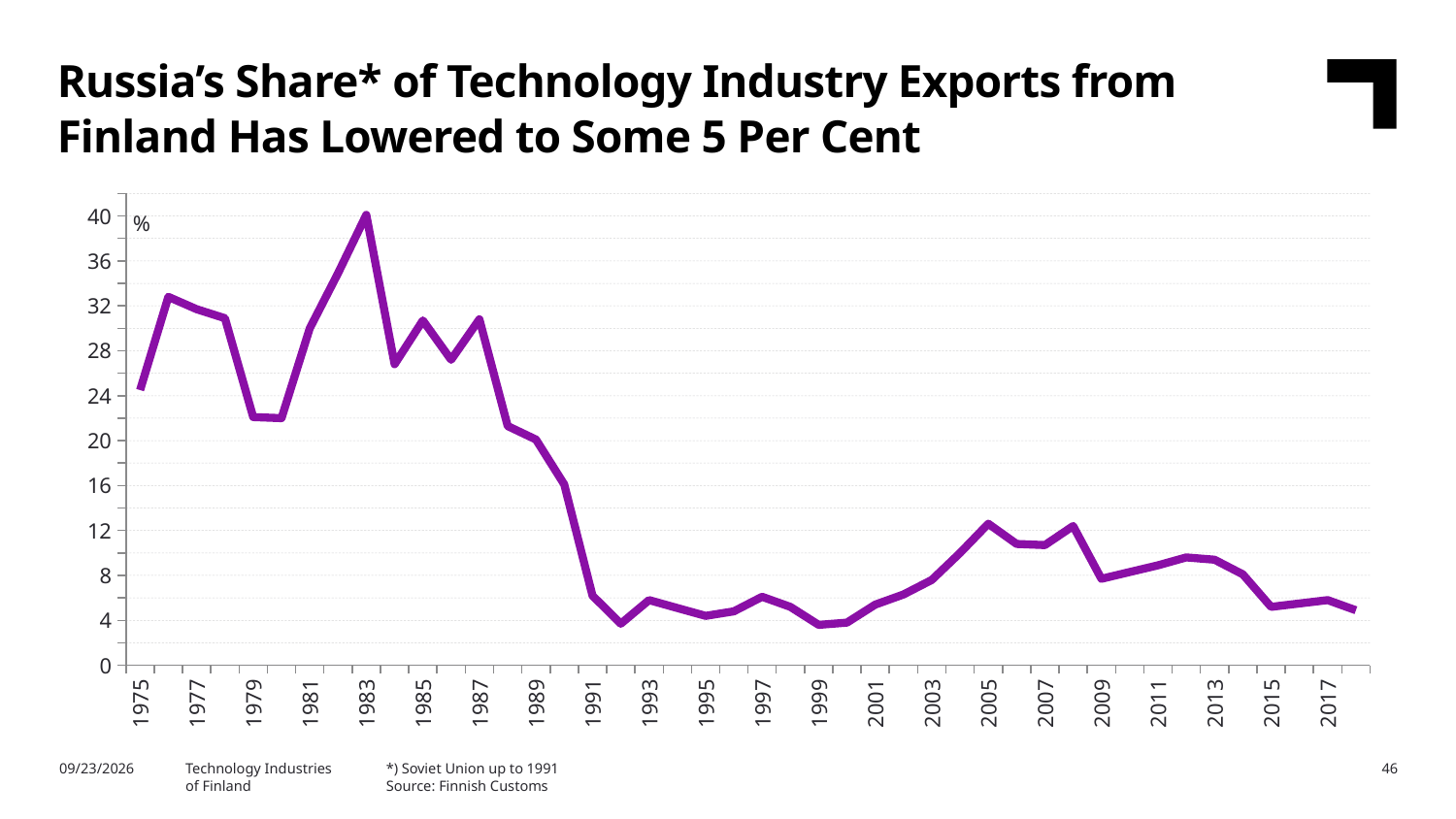
Overall, does the line rise or fall from 1975 to the end of the series? fall Is the value for 1989 greater or less than 16? greater Which year has the larger value, 1983 or 1987? 1983 Is the value for 1975 greater or less than 20? greater Is the value for 2009 greater or less than 12? less What kind of chart is shown on the slide? line chart In which year does the line reach its highest value? 1983 Which year has the larger value, 2005 or 2015? 2005 What unit is shown at the top of the y axis? %